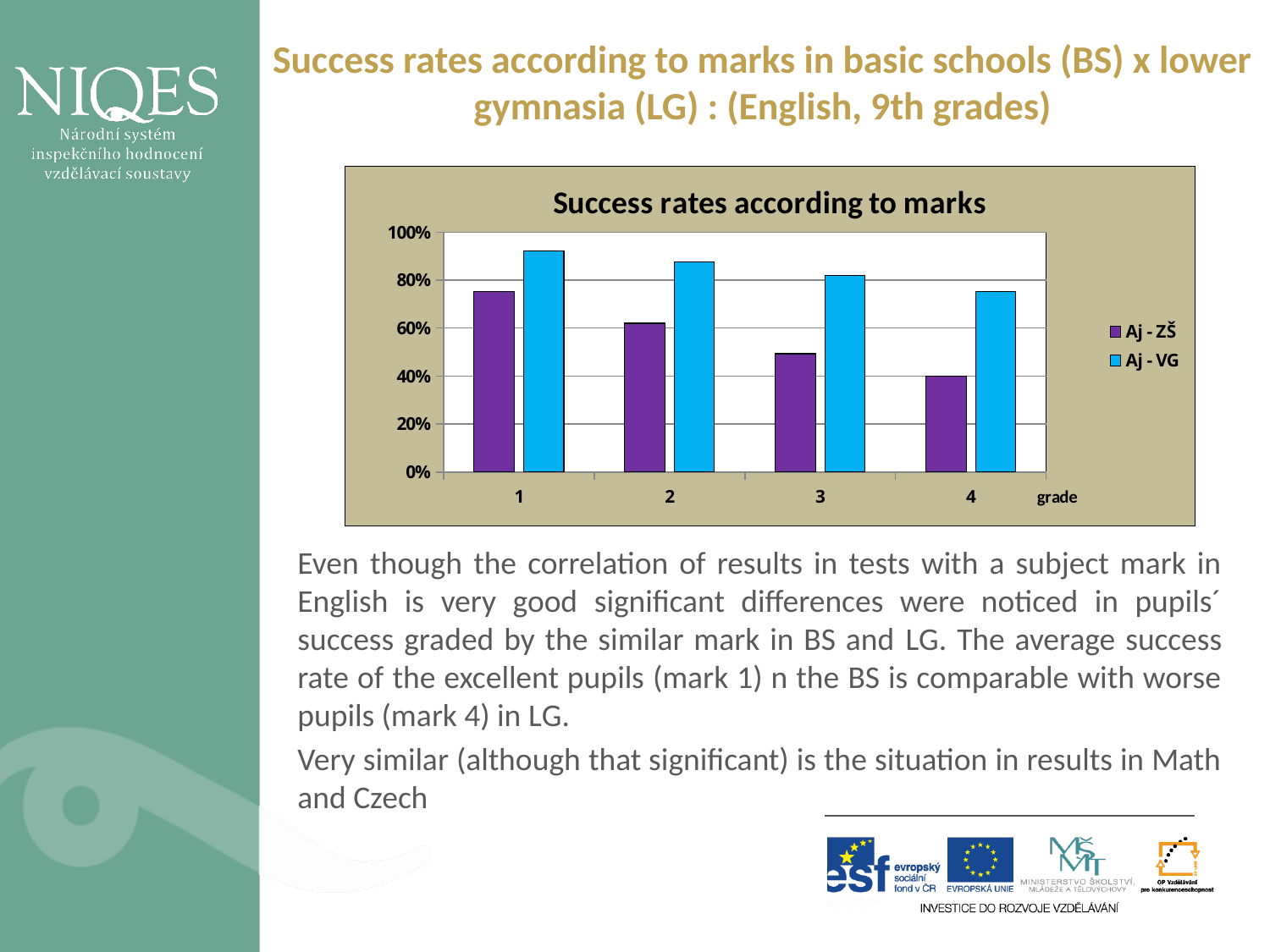
Which two series are listed in the legend? Aj - ZŠ and Aj - VG What kind of chart is shown on the slide? bar chart How many series does the legend list? 2 Do the Aj - ZŠ values rise or fall as the grade goes from 1 to 4? fall For which grade is the Aj - ZŠ value lowest? 4 Is the Aj - ZŠ value for grade 1 greater or less than 60%? greater For which grade is the Aj - VG value highest? 1 For grade 2, which series has the larger value, Aj - ZŠ or Aj - VG? Aj - VG How many grade categories are shown on the x axis? 4 What is the title of the chart? Success rates according to marks Is the Aj - VG value for grade 1 greater or less than 80%? greater Is the Aj - ZŠ value for grade 4 greater or less than 60%? less